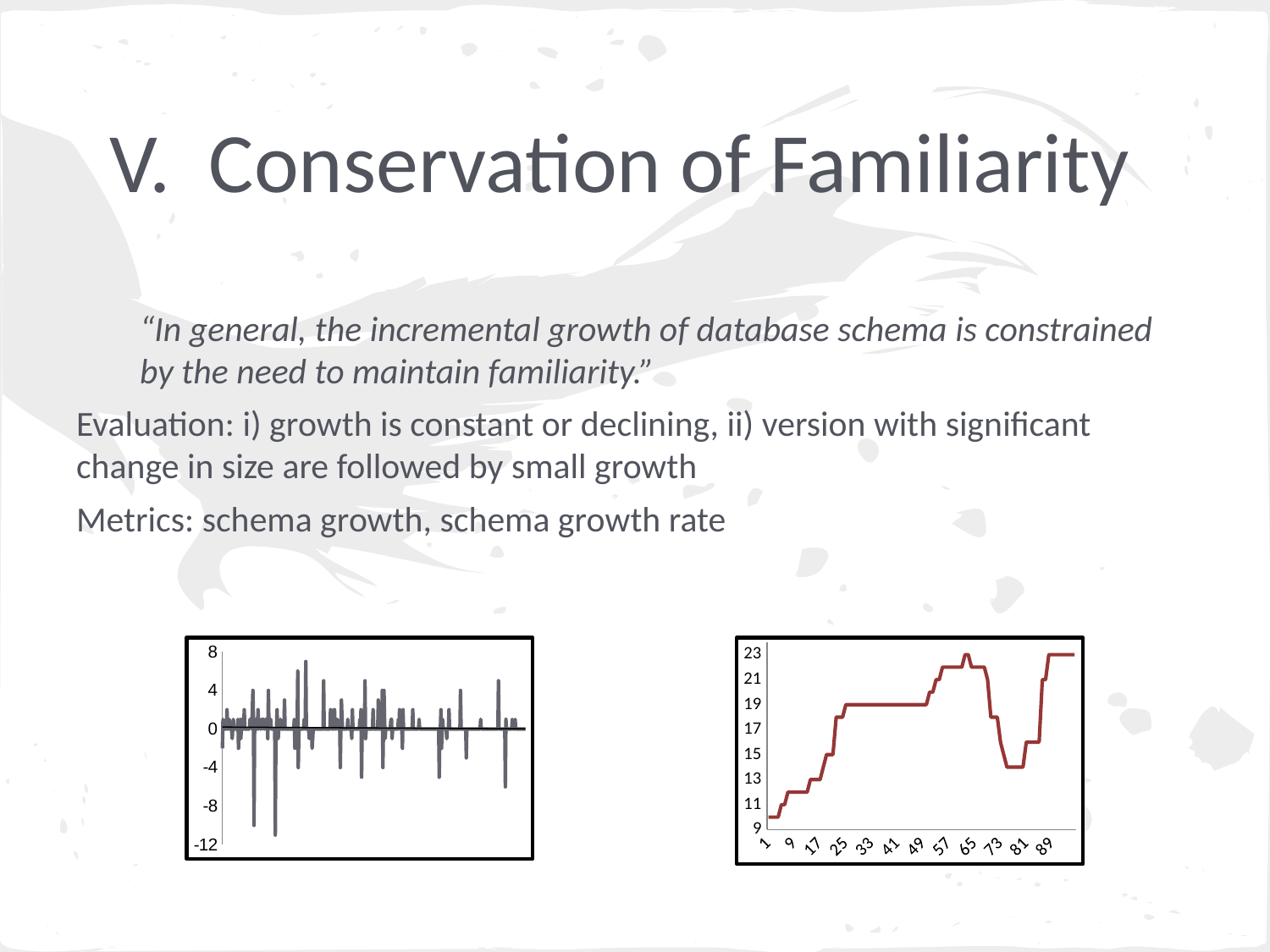
In the chart on the left, is the tallest positive bar greater or less than 4? greater In the chart on the left, is the lowest bar greater or less than -8? less In the chart on the right, is the value at version 1 greater or less than 11? less What kind of chart is the chart on the left of the slide? bar chart What kind of chart is the chart on the right of the slide? line chart What is the highest value shown on the y axis of the chart on the left? 8 In the chart on the right, does the line overall rise or fall from the first version to the last? rise What is the lowest value shown on the y axis of the chart on the right? 9